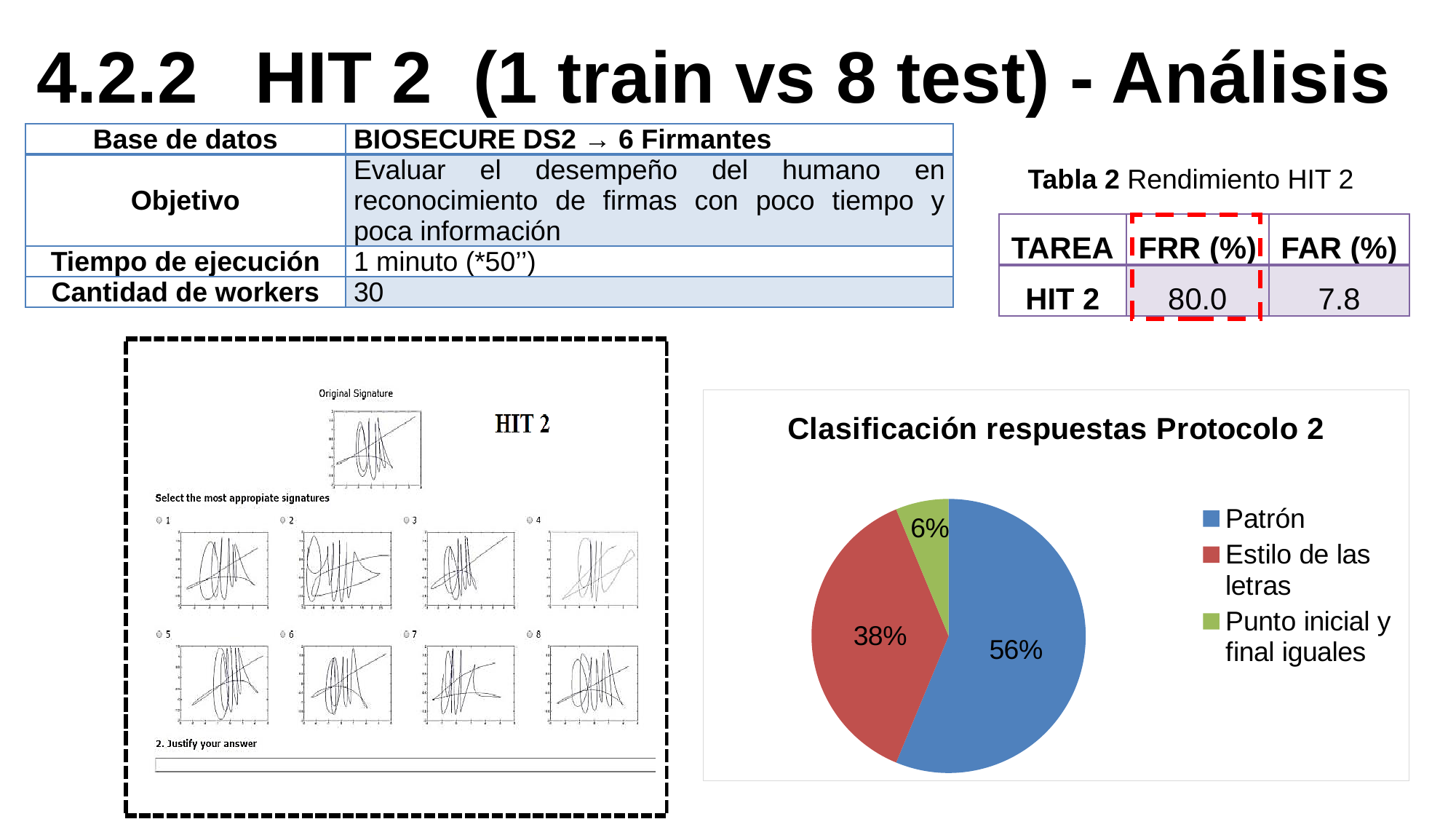
In the pie chart 'Clasificación respuestas Protocolo 2', what colour is the 'Patrón' slice? blue In the pie chart 'Clasificación respuestas Protocolo 2', what share does 'Punto inicial y final iguales' have? 6% In the pie chart 'Clasificación respuestas Protocolo 2', which category has the largest slice? Patrón What type of chart is 'Clasificación respuestas Protocolo 2'? pie chart What is the title of the pie chart on the slide? Clasificación respuestas Protocolo 2 How many slices does the pie chart 'Clasificación respuestas Protocolo 2' have? 3 In the pie chart 'Clasificación respuestas Protocolo 2', what share does 'Patrón' have? 56% How many entries does the legend of the pie chart 'Clasificación respuestas Protocolo 2' list? 3 In the pie chart 'Clasificación respuestas Protocolo 2', what is the difference in percentage points between 'Patrón' and 'Estilo de las letras'? 18 In the pie chart 'Clasificación respuestas Protocolo 2', which category has the smallest slice? Punto inicial y final iguales In the pie chart 'Clasificación respuestas Protocolo 2', which is larger: 'Estilo de las letras' or 'Punto inicial y final iguales'? Estilo de las letras In the pie chart 'Clasificación respuestas Protocolo 2', what share does 'Estilo de las letras' have? 38%